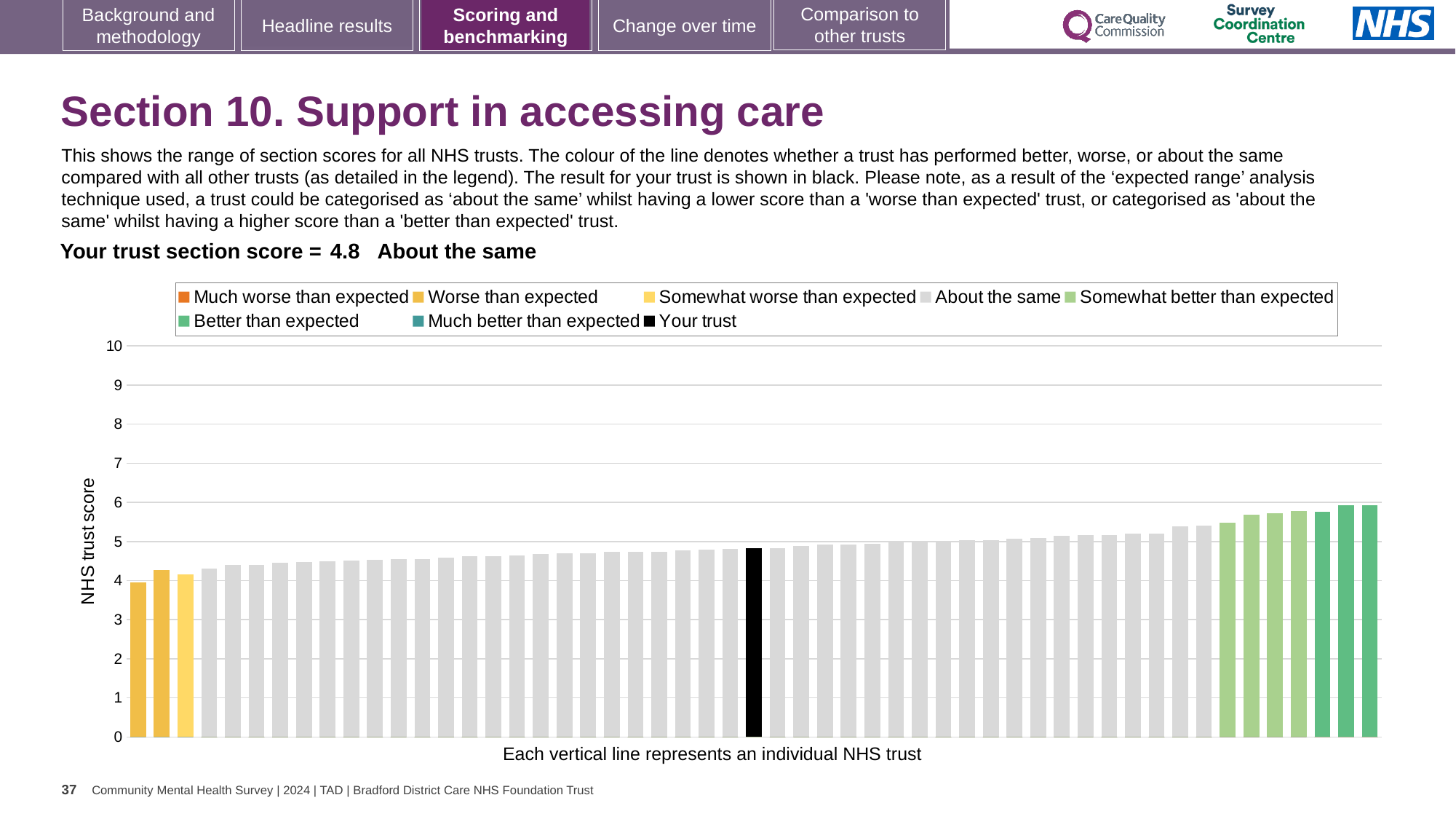
Is the value of the highest bar on the chart greater or less than 7? less Which legend category do the highest-scoring trusts (the rightmost bars) belong to? Better than expected What is the section score for your trust shown on the slide? 4.8 What colour is the bar representing your trust? Black What is the label on the vertical axis of the chart? NHS trust score Is the value for your trust (the black bar) greater or less than 5? less Do the bar values rise or fall from left to right along the x axis? Rise What kind of chart is shown on the slide? Bar chart Which legend category do the lowest-scoring trusts (the leftmost bars) belong to? Worse than expected How many categories does the chart legend list? 8 Is the value for your trust (the black bar) greater or less than 4? greater